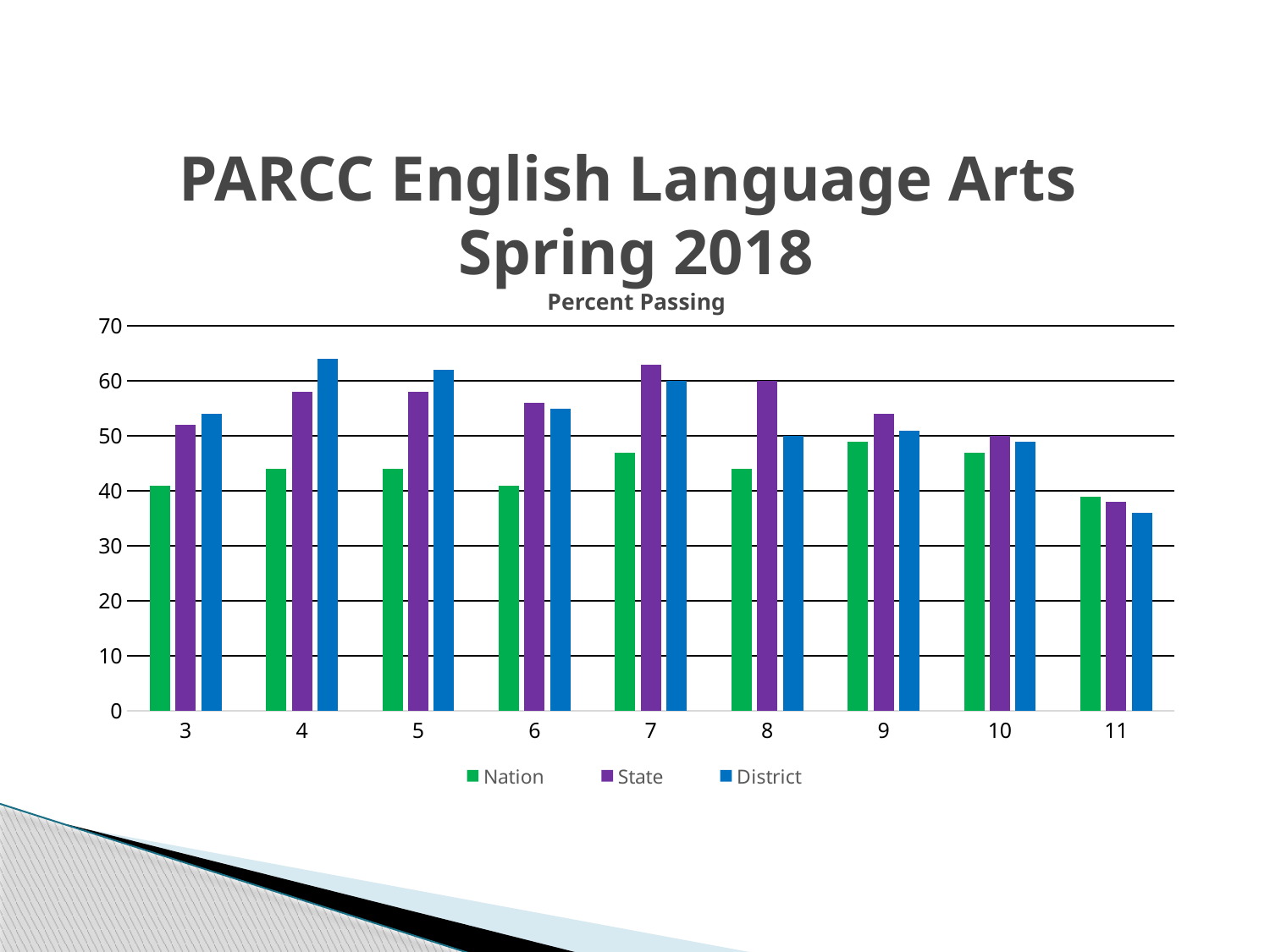
What kind of chart is shown on the slide? bar chart Is the State value for grade 6 greater or less than 50? greater For grade 4, which is larger, the Nation value or the District value? District Is the Nation value for grade 3 greater or less than 50? less For grade 8, which is larger, the State value or the District value? State How many grade categories are shown on the x axis? 9 What is the subtitle shown above the chart's plot area? Percent Passing Which grade has the lowest District value? 11 Which grade has the highest State value? 7 How many series does the legend list? 3 Is the District value for grade 4 greater or less than 60? greater